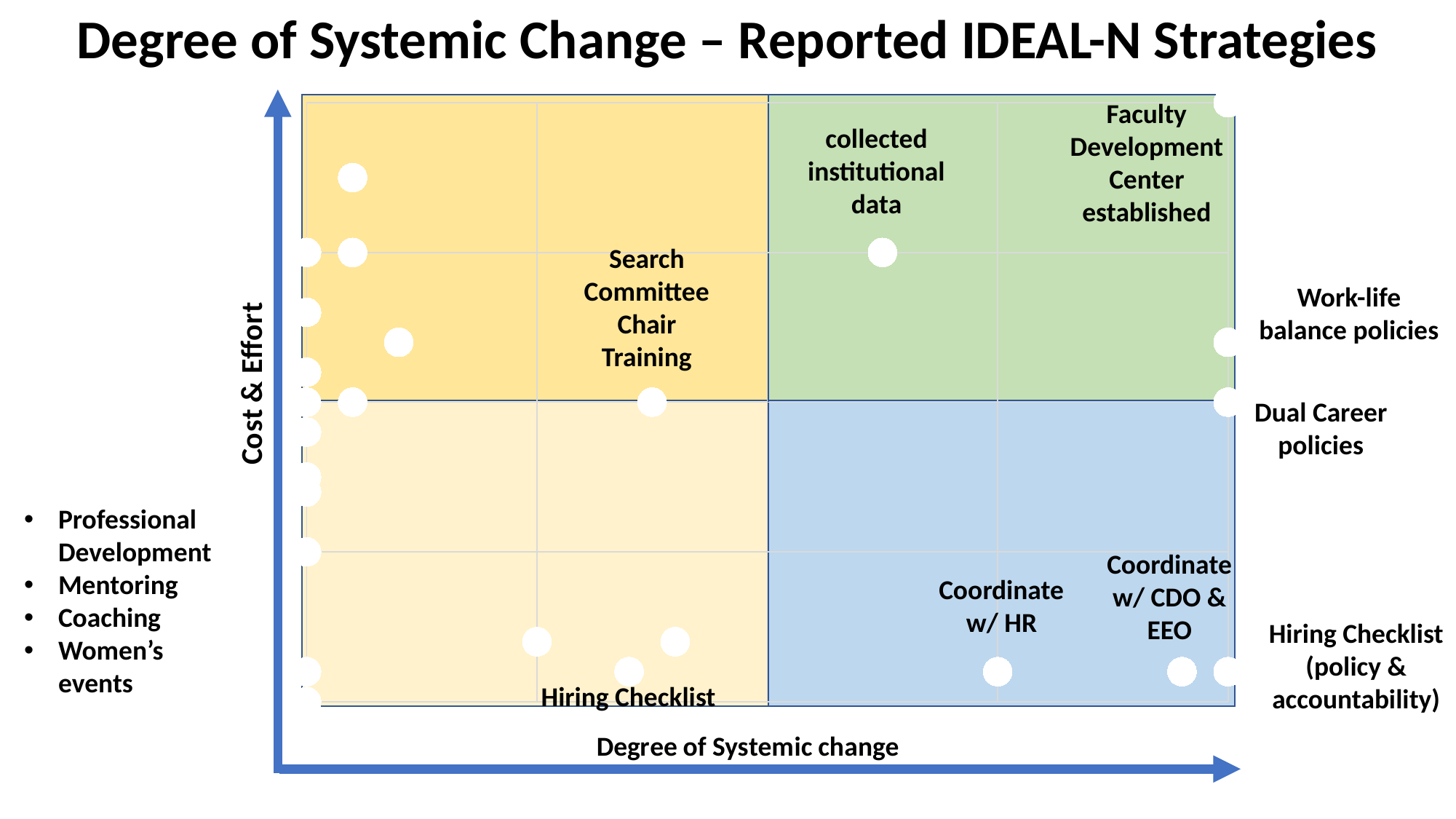
In which quadrant of the chart (upper-left, upper-right, lower-left or lower-right) is Coordinate w/ HR plotted? lower-right What is the label of the horizontal axis? Degree of Systemic change What is the label of the vertical axis? Cost & Effort Which is plotted further along the Degree of Systemic change axis: collected institutional data or Faculty Development Center established? Faculty Development Center established Which is plotted higher on the Cost & Effort axis: collected institutional data or Hiring Checklist (policy & accountability)? collected institutional data Which is plotted higher on the Cost & Effort axis: Faculty Development Center established or Coordinate w/ HR? Faculty Development Center established What kind of chart is shown on the slide? scatter chart In which quadrant of the chart (upper-left, upper-right, lower-left or lower-right) is collected institutional data plotted? upper-right Which labeled strategy is plotted highest on the Cost & Effort axis? Faculty Development Center established